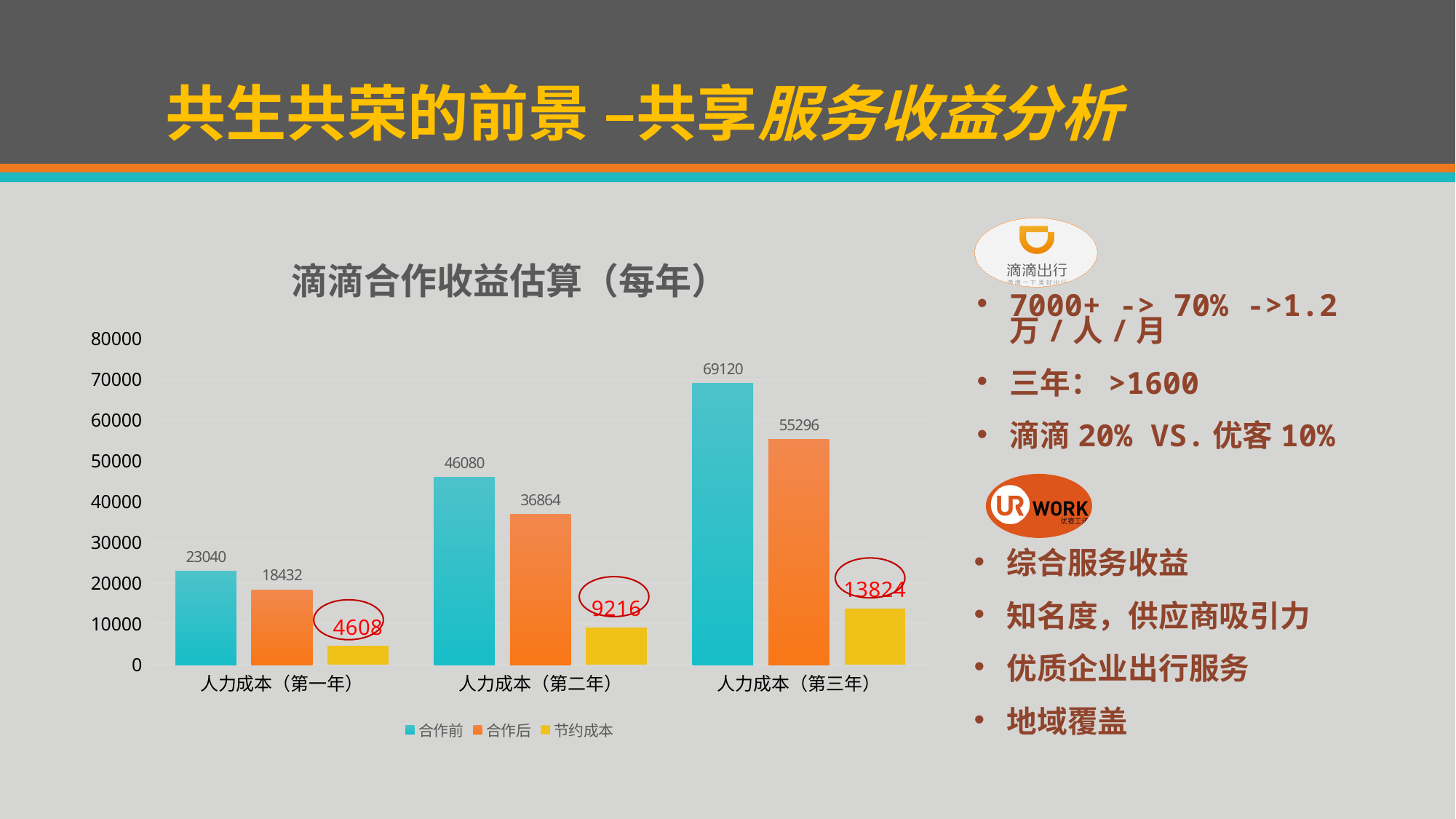
What kind of chart is shown? Bar chart What is the value of 合作前 for 人力成本（第一年）? 23040 What is the value of 合作后 for 人力成本（第三年）? 55296 Which is larger: 合作后 for 人力成本（第二年） or 合作前 for 人力成本（第一年）? 合作后 for 人力成本（第二年） What is the value of 节约成本 for 人力成本（第三年）? 13824 Which category has the highest 合作前 value? 人力成本（第三年） How many categories are shown on the x axis? 3 What is the value of 合作后 for 人力成本（第二年）? 36864 Which category has the lowest 节约成本 value? 人力成本（第一年） How many series does the legend list? 3 Do the 合作前 values rise or fall from 第一年 to 第三年? Rise What is the difference between 合作前 and 合作后 for 人力成本（第二年）? 9216